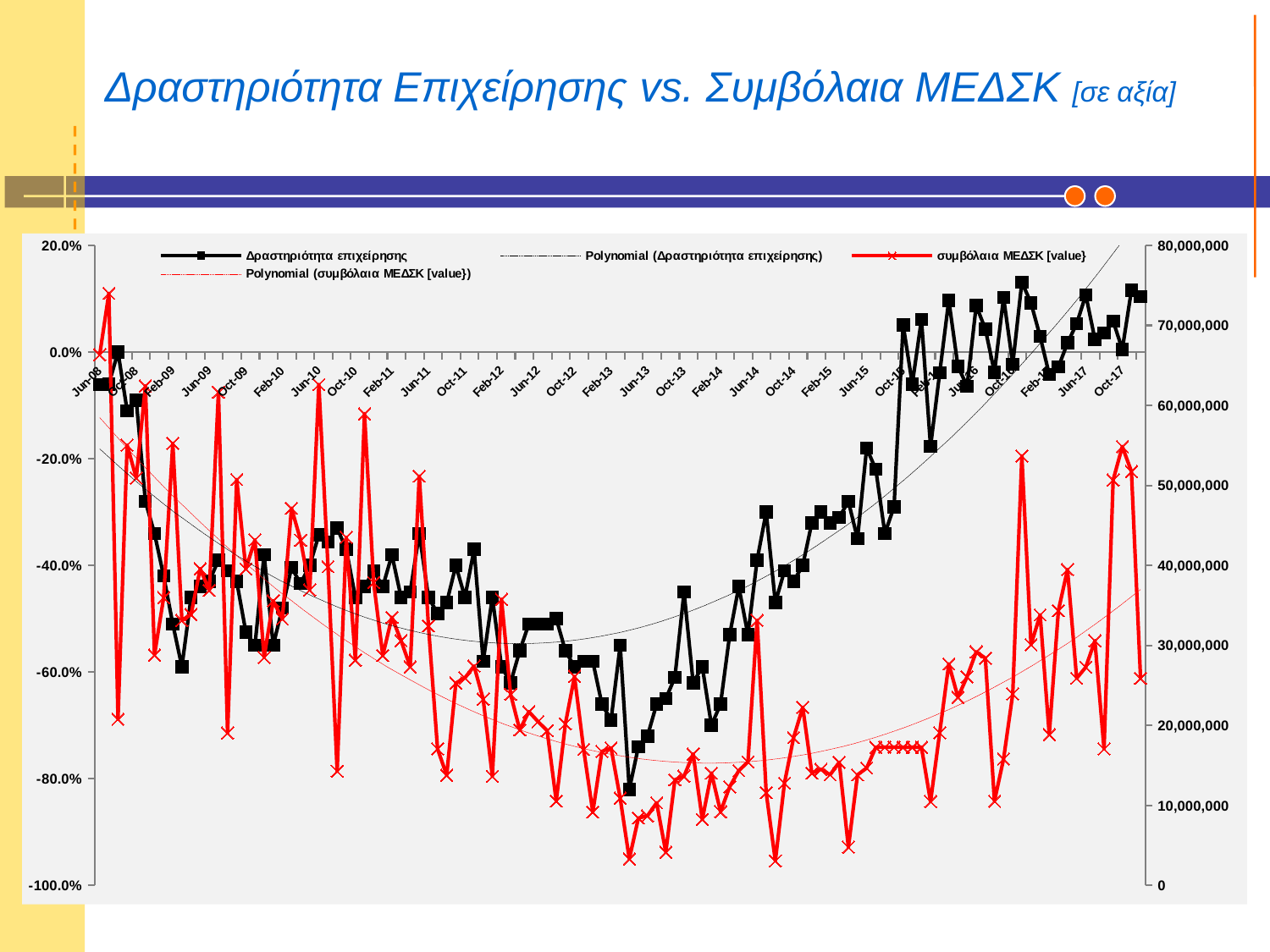
Does the Δραστηριότητα επιχείρησης series rise or fall between Jun-13 and Oct-17? rise What is the maximum value shown on the right-hand vertical axis? 80,000,000 What is the title of the slide containing the chart? Δραστηριότητα Επιχείρησης vs. Συμβόλαια ΜΕΔΣΚ [σε αξία] How many series does the legend list? 4 Is the value of Δραστηριότητα επιχείρησης at Jun-13 greater or less than -60.0%? less Which series is drawn in red with x markers? συμβόλαια ΜΕΔΣΚ [value} Is the value of συμβόλαια ΜΕΔΣΚ [value] at Jun-08 greater or less than 60,000,000? greater What kind of chart is shown on the slide? line chart Is the value of Δραστηριότητα επιχείρησης at Feb-12 greater or less than -40.0%? less